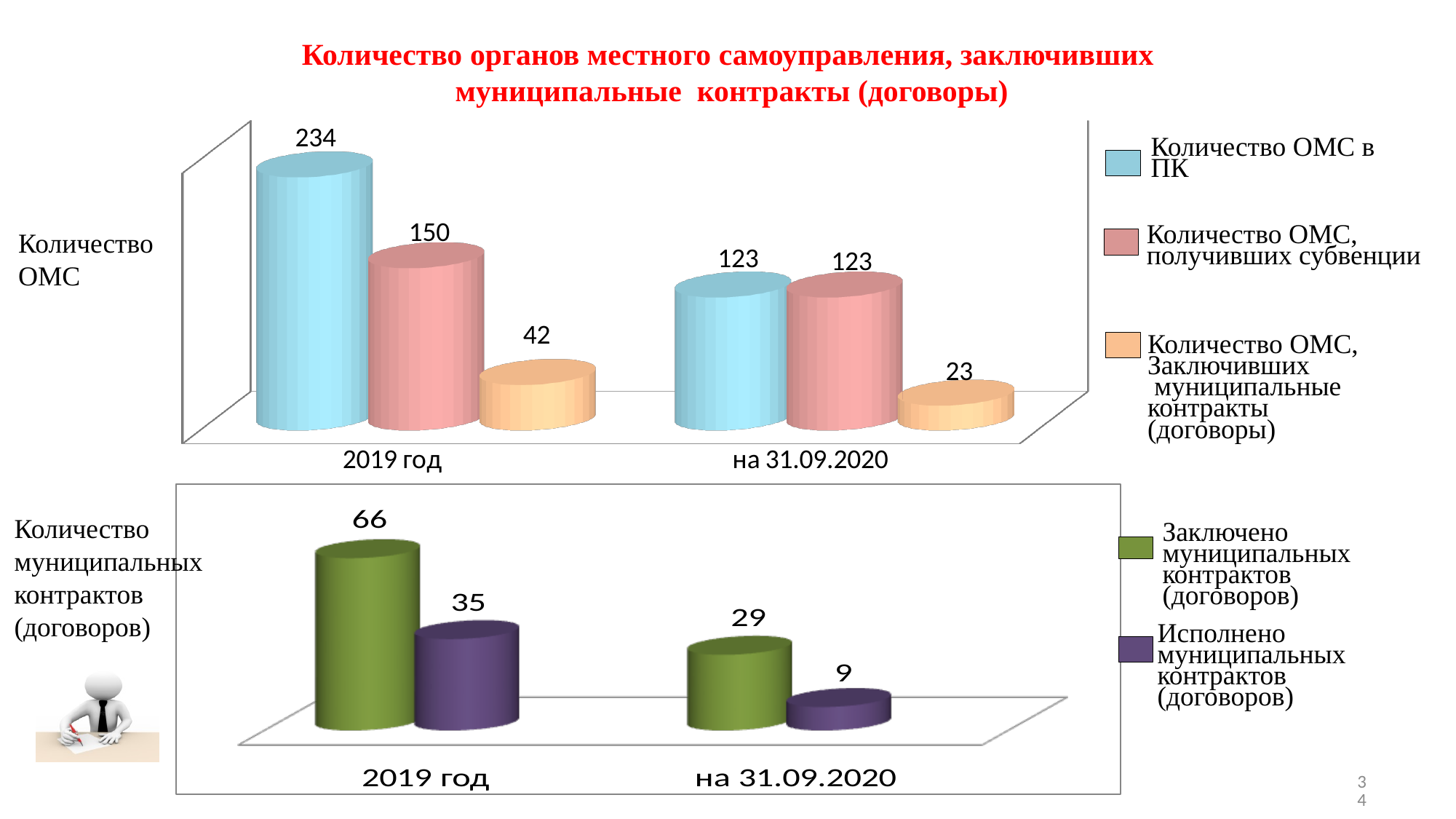
What kind of chart is the bottom chart? bar chart In the bottom chart, what is the value for "Исполнено муниципальных контрактов (договоров)" на 31.09.2020? 9 In the top chart, what is the difference between "Количество ОМС в ПК" and "Количество ОМС, получивших субвенции" in 2019 год? 84 In the top chart, how many series does the legend list? 3 In the top chart, what is the value for "Количество ОМС в ПК" in 2019 год? 234 In the top chart, does the value for "Количество ОМС в ПК" rise or fall from 2019 год to 31.09.2020? fall In the bottom chart, what is the difference between "Заключено" and "Исполнено" муниципальных контрактов in 2019 год? 31 In the top chart, what is the value for "Количество ОМС, Заключивших муниципальные контракты (договоры)" на 31.09.2020? 23 In the top chart, what is the value for "Количество ОМС, получивших субвенции" in 2019 год? 150 In the bottom chart, what is the value for "Заключено муниципальных контрактов (договоров)" in 2019 год? 66 In the top chart, which series has the lowest value in 2019 год? Количество ОМС, Заключивших муниципальные контракты (договоры) In the bottom chart, how many categories are shown on the x axis? 2